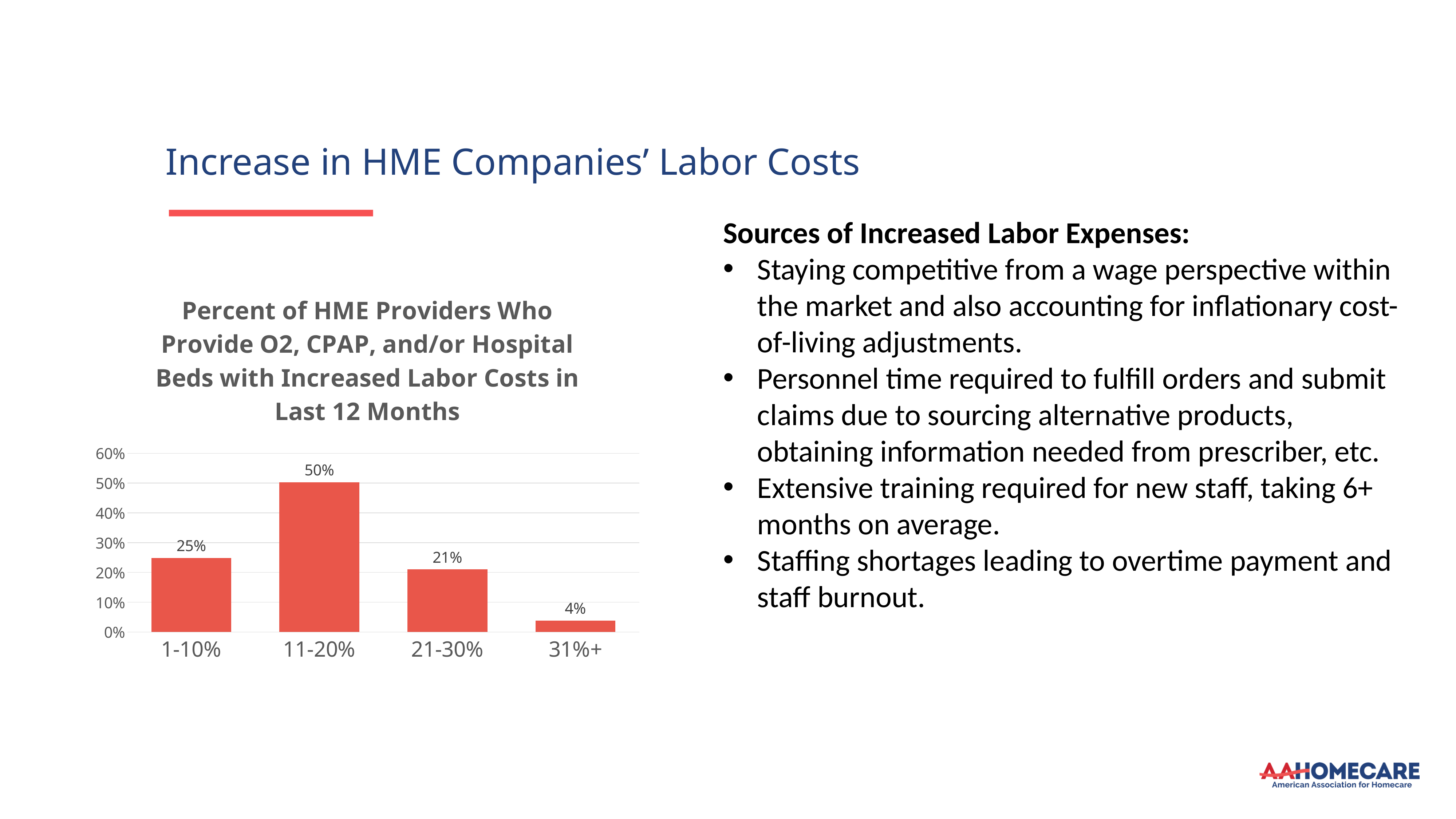
What is the value for the 21-30% category? 21% What kind of chart is shown on the slide? Bar chart What is the value for the 1-10% category? 25% What is the value for the 31%+ category? 4% What is the title of the chart? Percent of HME Providers Who Provide O2, CPAP, and/or Hospital Beds with Increased Labor Costs in Last 12 Months What is the difference between the values for 11-20% and 1-10%? 25% How many categories are shown on the x axis? 4 Which is larger, the value for 1-10% or the value for 21-30%? 1-10% What is the difference between the values for 21-30% and 31%+? 17% Which category has the lowest value? 31%+ Which category has the highest value? 11-20% What percent of HME providers reported increased labor costs of 11-20%? 50%